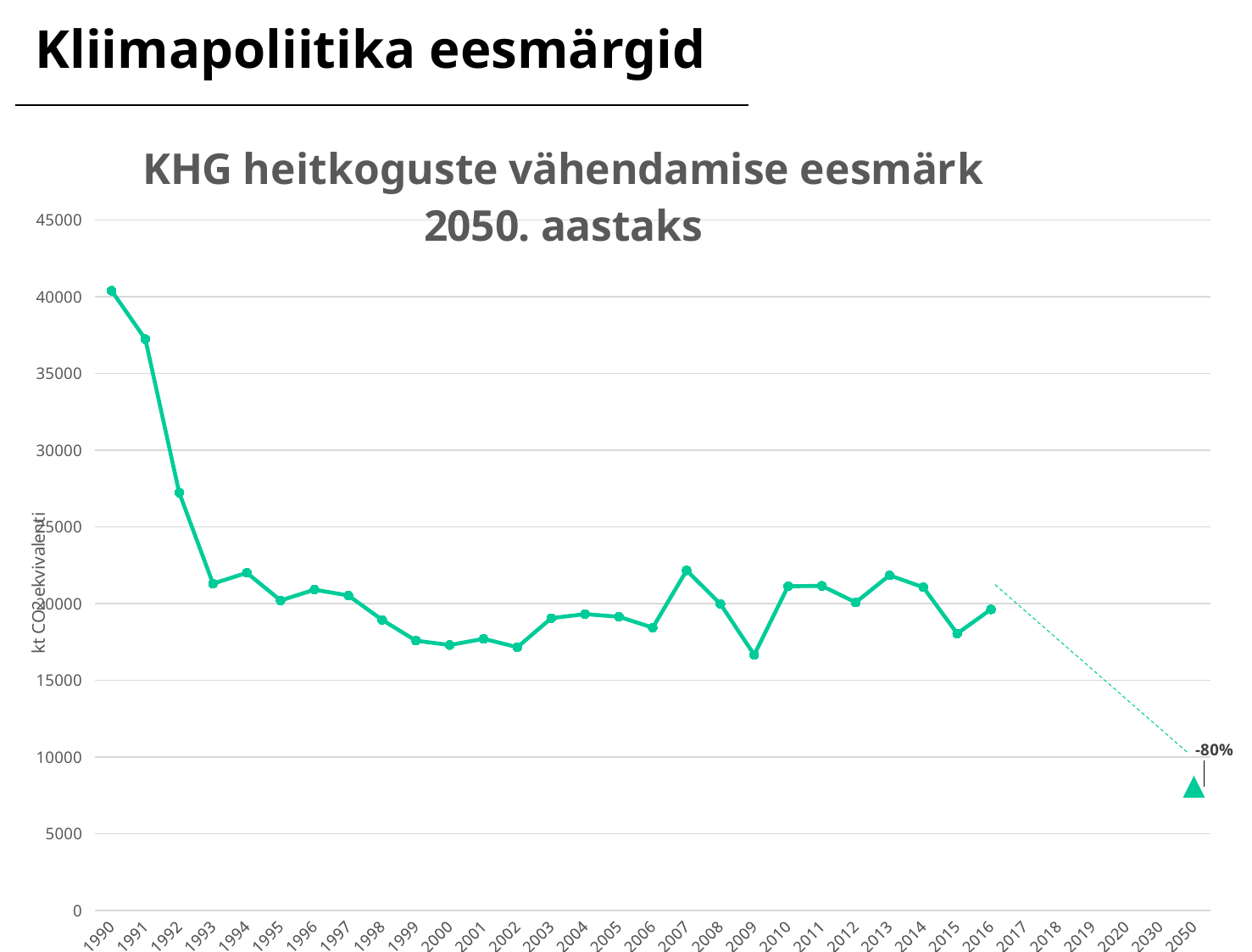
Is the value for 1992 greater or less than 25000? greater What kind of chart is shown on the slide? line chart Is the value for 1991 greater or less than 35000? greater Which year has the larger value, 2007 or 2009? 2007 What label is printed next to the 2050 target marker on the chart? -80% Do the values rise or fall from 1990 to 1993? fall Which year has the larger value, 1990 or 2016? 1990 Is the value for 2015 greater or less than 20000? less What is the title of the chart? KHG heitkoguste vähendamise eesmärk 2050. aastaks Which year has the highest emissions value on the chart? 1990